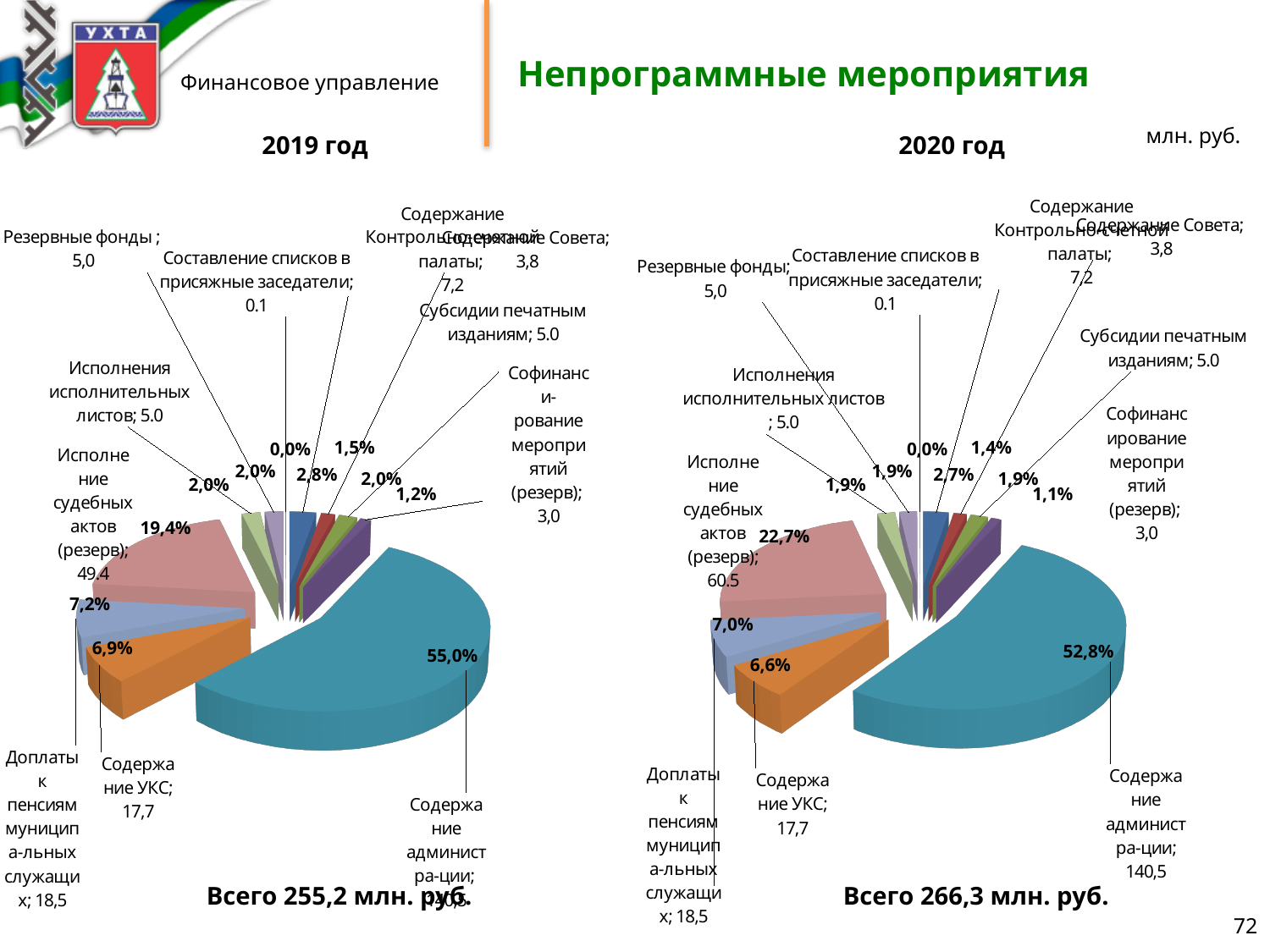
In the 2020 год chart, what is the value for Содержание УКС? 17,7 What total is stated below the 2020 год chart? Всего 266,3 млн. руб. In the 2020 год chart, which category has the smallest value? Составление списков в присяжные заседатели In the 2019 год chart, what share of the pie does Содержание Контрольно-счетной палаты take? 2,8% What is the difference between the value for Исполнение судебных актов (резерв) in the 2020 год chart and in the 2019 год chart? 11.1 In the 2020 год chart, which is larger: Доплаты к пенсиям муниципальных служащих or Содержание УКС? Доплаты к пенсиям муниципальных служащих In the 2020 год chart, what share of the pie does Исполнение судебных актов (резерв) take? 22,7% In the 2019 год chart, what share of the pie does Содержание администрации take? 55,0% In the 2019 год chart, which category has the largest slice? Содержание администрации In the 2020 год chart, what is the value for Содержание администрации? 140,5 What kind of chart is used for the 2019 год data? pie chart In the 2019 год chart, what is the value for Исполнение судебных актов (резерв)? 49.4